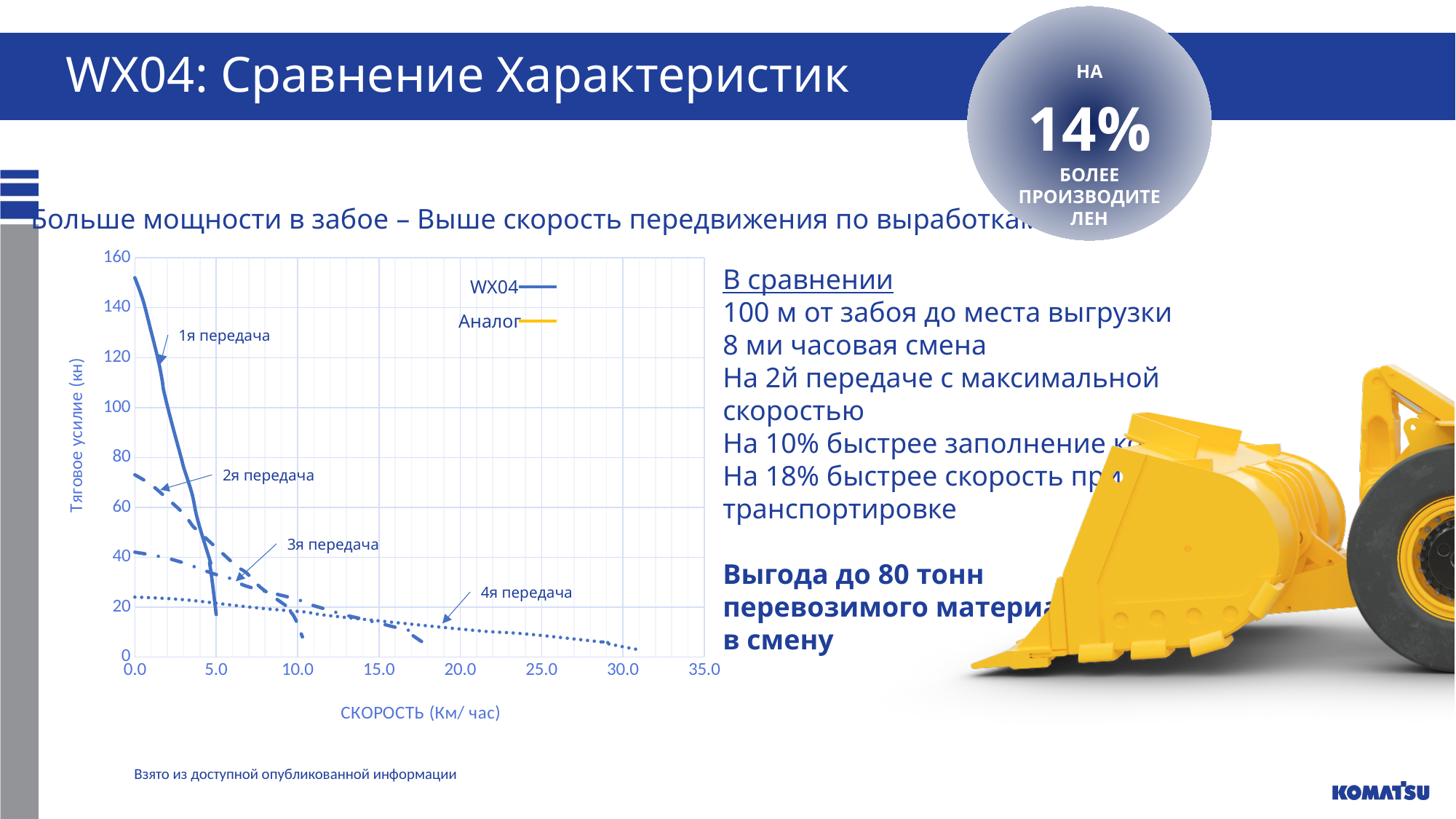
Is the WX04 3rd gear (3я передача) tractive effort at speed 0.0 greater or less than 60? less Is the WX04 2nd gear (2я передача) tractive effort at speed 0.0 greater or less than 60? greater What are the two series named in the chart legend? WX04 and Аналог Which WX04 gear curve reaches the highest speed on the x axis? 4я передача Is the WX04 4th gear (4я передача) tractive effort at speed 0.0 greater or less than 40? less What is the title of the x axis of the chart? СКОРОСТЬ (Км/ час) What is the highest value shown on the y axis (Тяговое усилие) of the chart? 160 How many gear (передача) curves are labelled on the chart? 4 Does the WX04 1st gear (1я передача) tractive effort rise or fall as speed increases? fall How many series does the chart legend list? 2 What kind of chart is shown on the slide? line chart